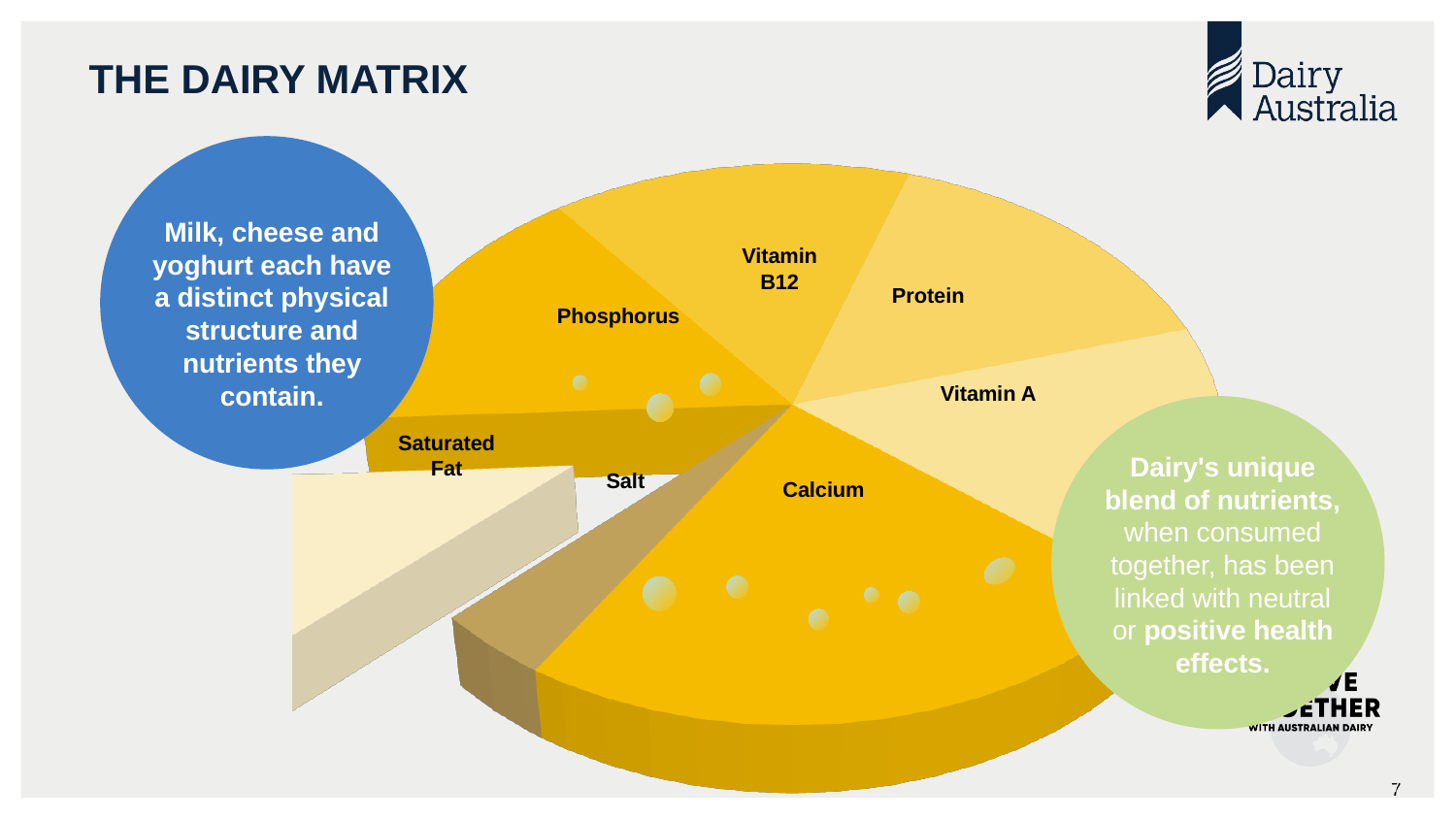
Which slice of the pie chart is the smallest? Salt How many slices does the pie chart have? 7 What kind of chart is shown on the slide? Pie chart Which slice lies between Phosphorus and Protein in the pie chart? Vitamin B12 Which slice is larger, Calcium or Vitamin A? Calcium Which slice is larger, Calcium or Salt? Calcium Which slice of the pie chart is the largest? Calcium Which slice is pulled out (exploded) from the rest of the pie chart? Saturated Fat Which slice is larger, Phosphorus or Salt? Phosphorus